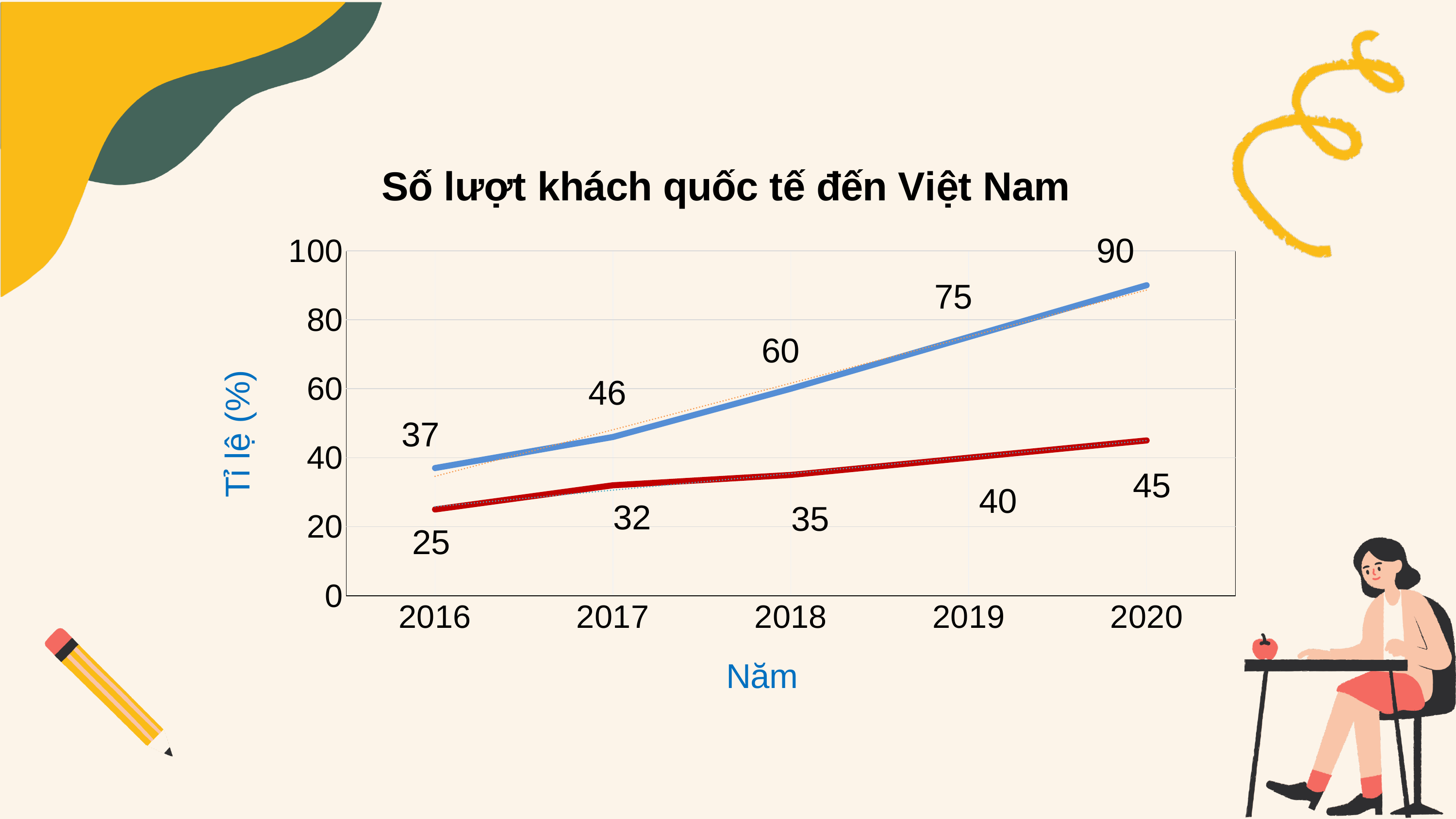
How many years are shown on the x axis? 5 In which year does the red line have its lowest value? 2016 What is the title of the chart? Số lượt khách quốc tế đến Việt Nam Does the red line rise or fall from 2016 to 2020? Rise What is the value of the red line in 2019? 40 What is the difference between the blue line and the red line in 2020? 45 How many lines are plotted on the chart? 2 What type of chart is shown on the slide? Line chart What is the value of the blue line in 2018? 60 What is the value of the blue line in 2016? 37 Which line has the larger value in 2017, the blue line or the red line? The blue line In which year does the blue line reach its highest value? 2020